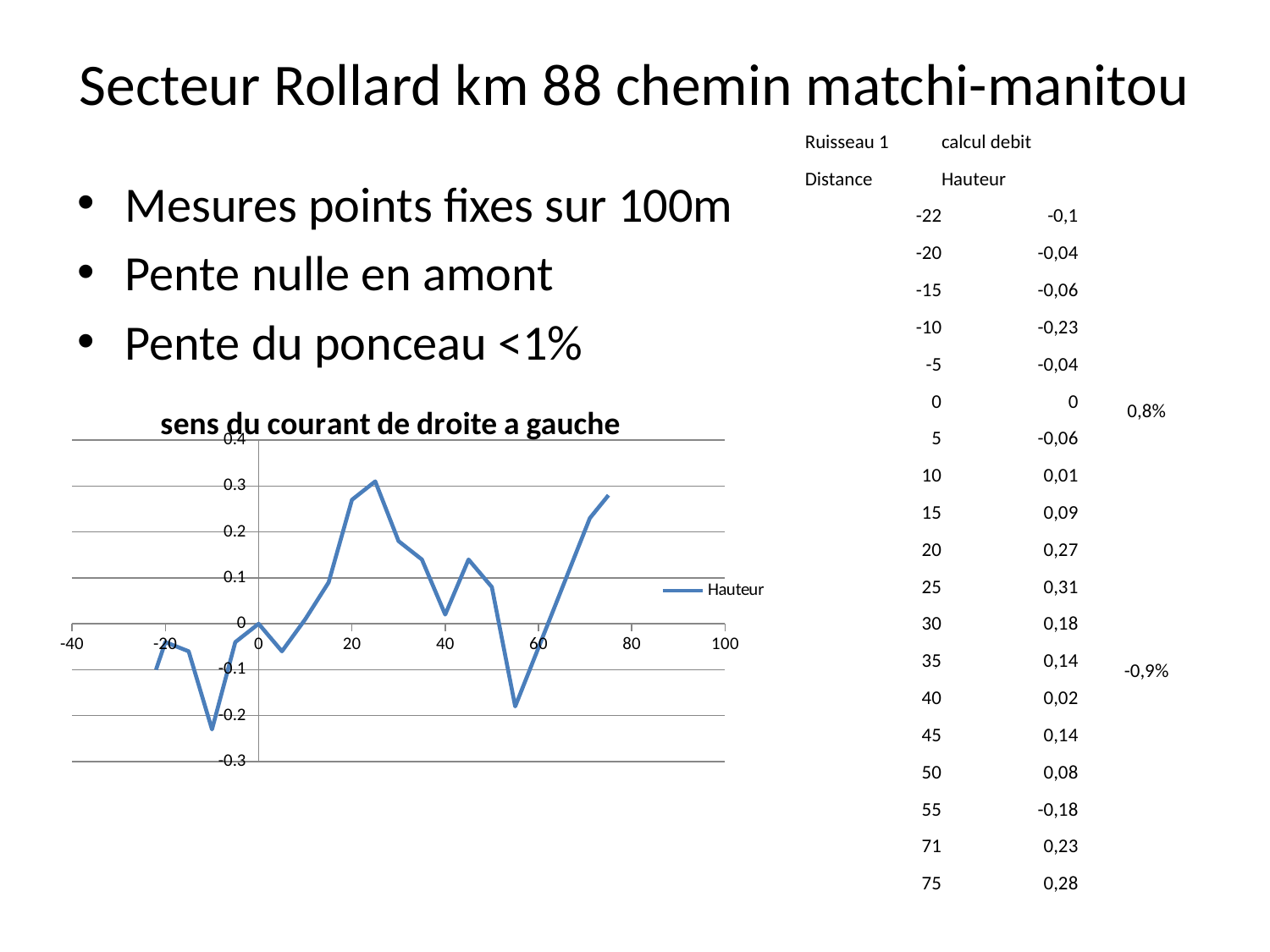
What is the name of the series shown in the chart legend? Hauteur What is the title of the chart? sens du courant de droite a gauche Is the Hauteur value at distance 40 greater or less than 0.1? less At which distance does the Hauteur line reach its lowest value? -10 Is the Hauteur value at distance 20 greater or less than 0.2? greater What kind of chart is shown on the slide? line chart How many data points are plotted on the Hauteur line? 19 Does the Hauteur line rise or fall between distance 55 and distance 75? rise Which has the larger Hauteur value, distance 25 or distance 40? distance 25 How many series does the chart legend list? 1 At which distance does the Hauteur line reach its highest value? 25 Is the Hauteur value at distance 55 greater or less than -0.1? less